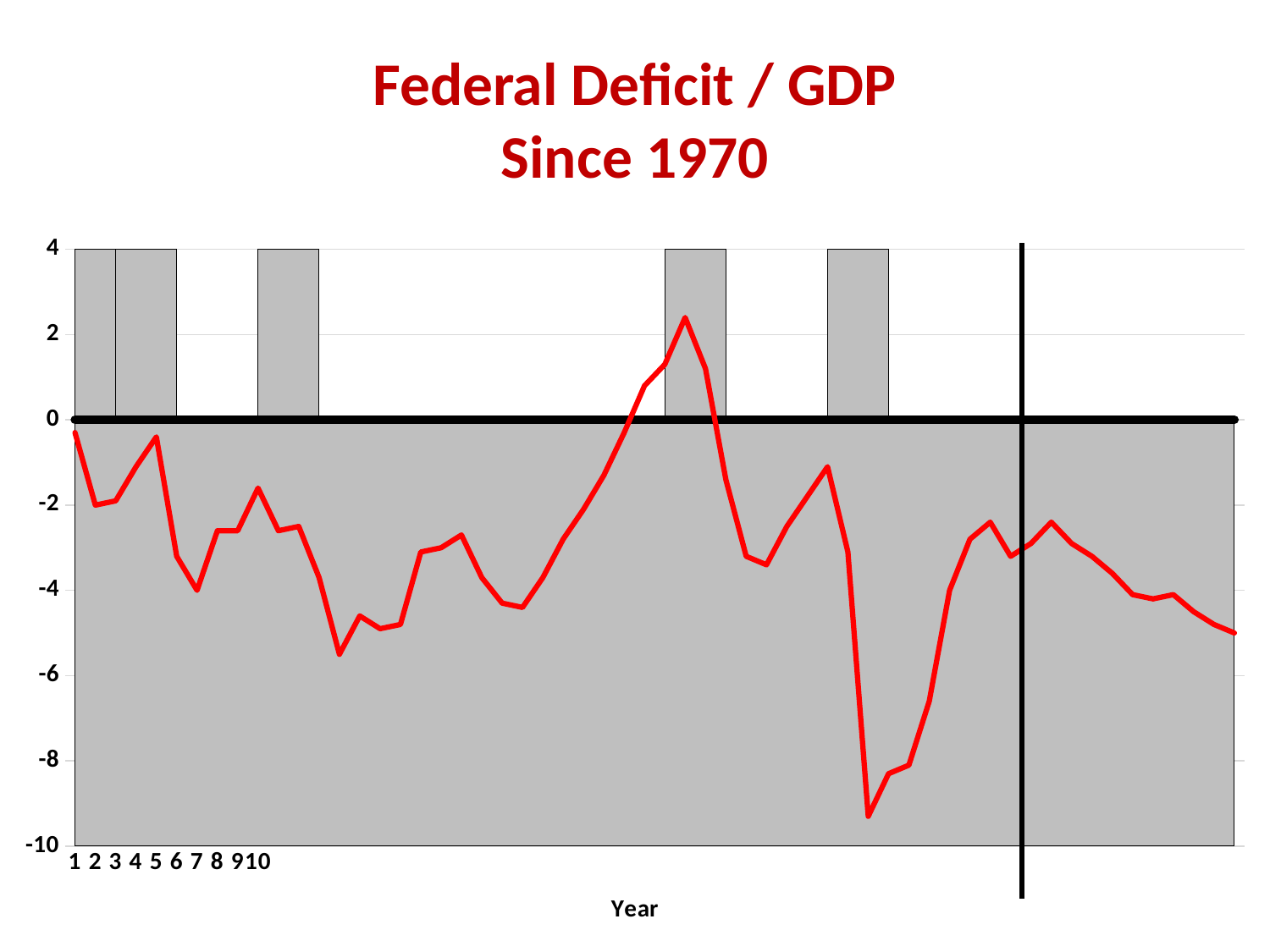
Is the lowest value reached by the red line greater or less than -8? less What is the label of the x axis? Year Which is larger, the value for year 1 or the value for year 7? year 1 Is the highest value reached by the red line greater or less than 2? greater Is the value for year 6 greater or less than -4? greater What is the highest tick value shown on the y axis? 4 What is the title of the chart? Federal Deficit / GDP Since 1970 What kind of chart is shown on the slide? line chart